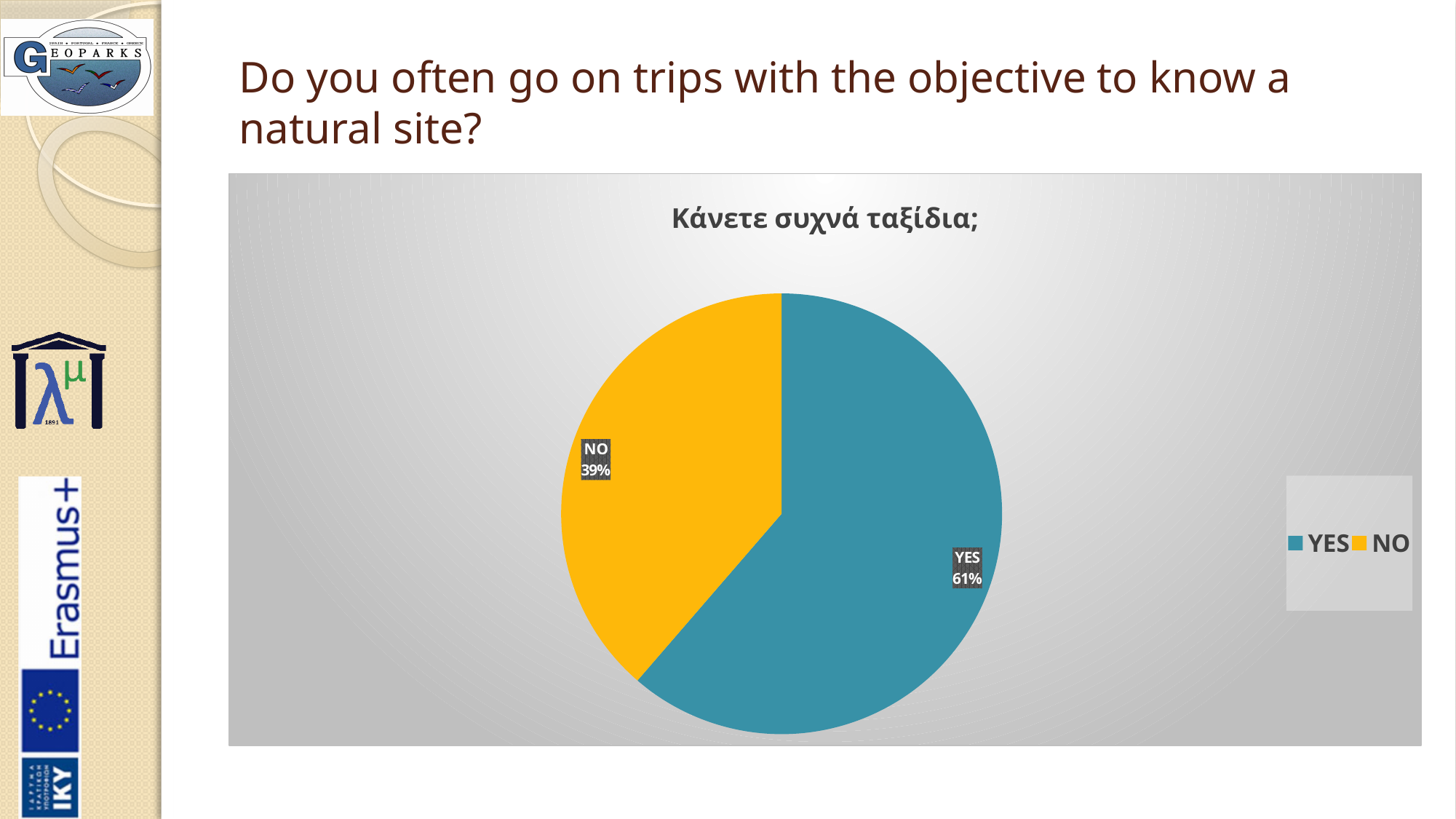
Which is larger, the YES share or the NO share? YES Which response has the smallest share of the pie? NO What percentage of respondents answered NO? 39% What kind of chart is shown on the slide? Pie chart What is the difference in percentage points between the YES and NO shares? 22 What share of the pie does the NO slice represent? 39% What percentage of respondents answered YES? 61% Which response has the largest share of the pie? YES How many entries does the legend list? 2 How many slices does the pie chart have? 2 What is the title of the chart? Κάνετε συχνά ταξίδια; What colour is the YES slice in the pie chart? Teal blue